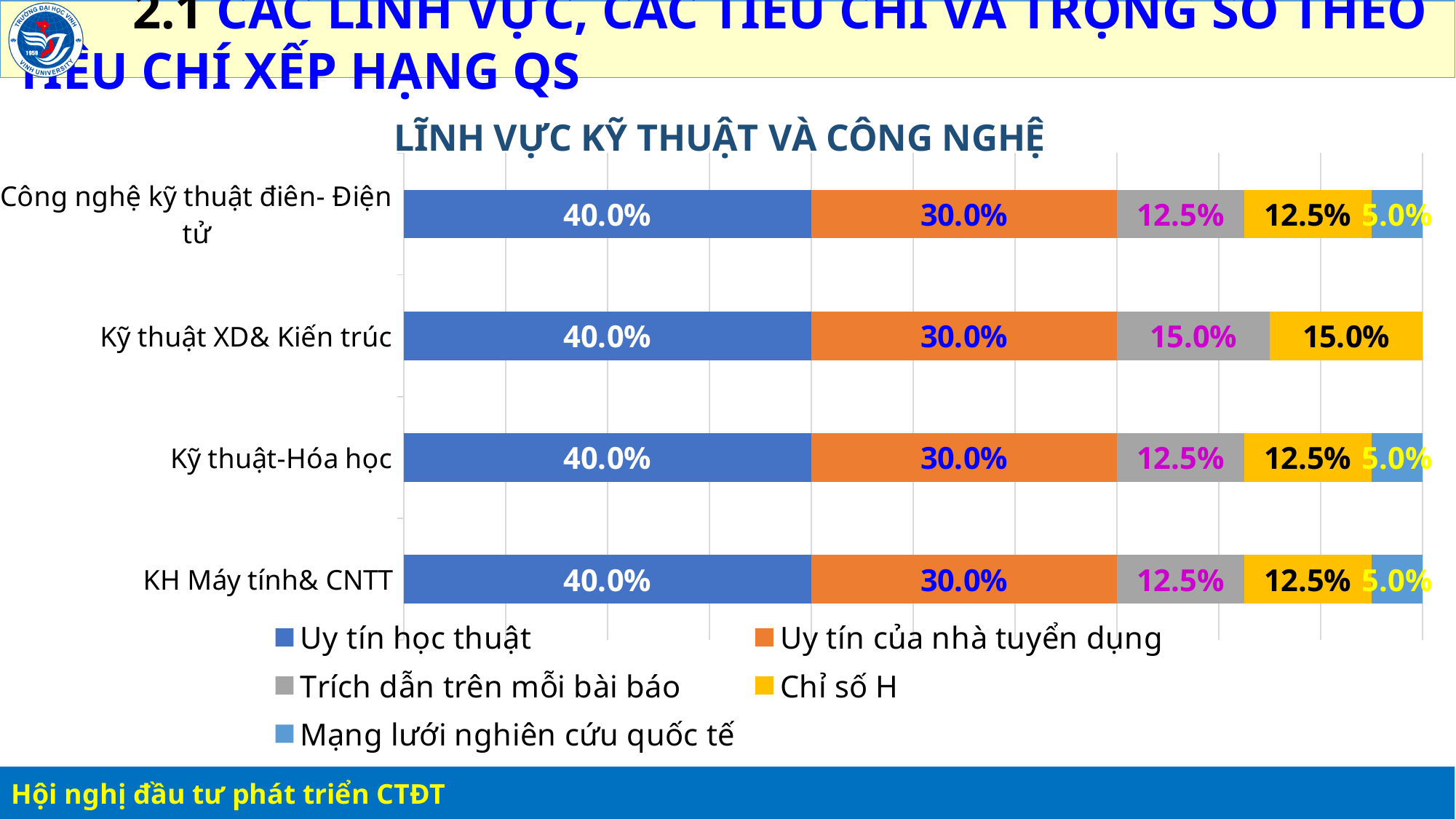
What is the value of Mạng lưới nghiên cứu quốc tế for Công nghệ kỹ thuật điên- Điện tử? 5.0% What is the value of Trích dẫn trên mỗi bài báo for Kỹ thuật XD& Kiến trúc? 15.0% What kind of chart is shown on the slide? Stacked bar chart Which series has the smallest value for Kỹ thuật-Hóa học? Mạng lưới nghiên cứu quốc tế What is the value of Uy tín học thuật for Kỹ thuật-Hóa học? 40.0% How many series does the legend list? 5 What is the value of Uy tín của nhà tuyển dụng for KH Máy tính& CNTT? 30.0% How many categories (programme groups) are plotted on the chart? 4 What is the value of Chỉ số H for Kỹ thuật XD& Kiến trúc? 15.0% What is the difference between the Trích dẫn trên mỗi bài báo value for Kỹ thuật XD& Kiến trúc and for Kỹ thuật-Hóa học? 2.5% What is the title of the chart? LĨNH VỰC KỸ THUẬT VÀ CÔNG NGHỆ Which series has the largest value for KH Máy tính& CNTT? Uy tín học thuật